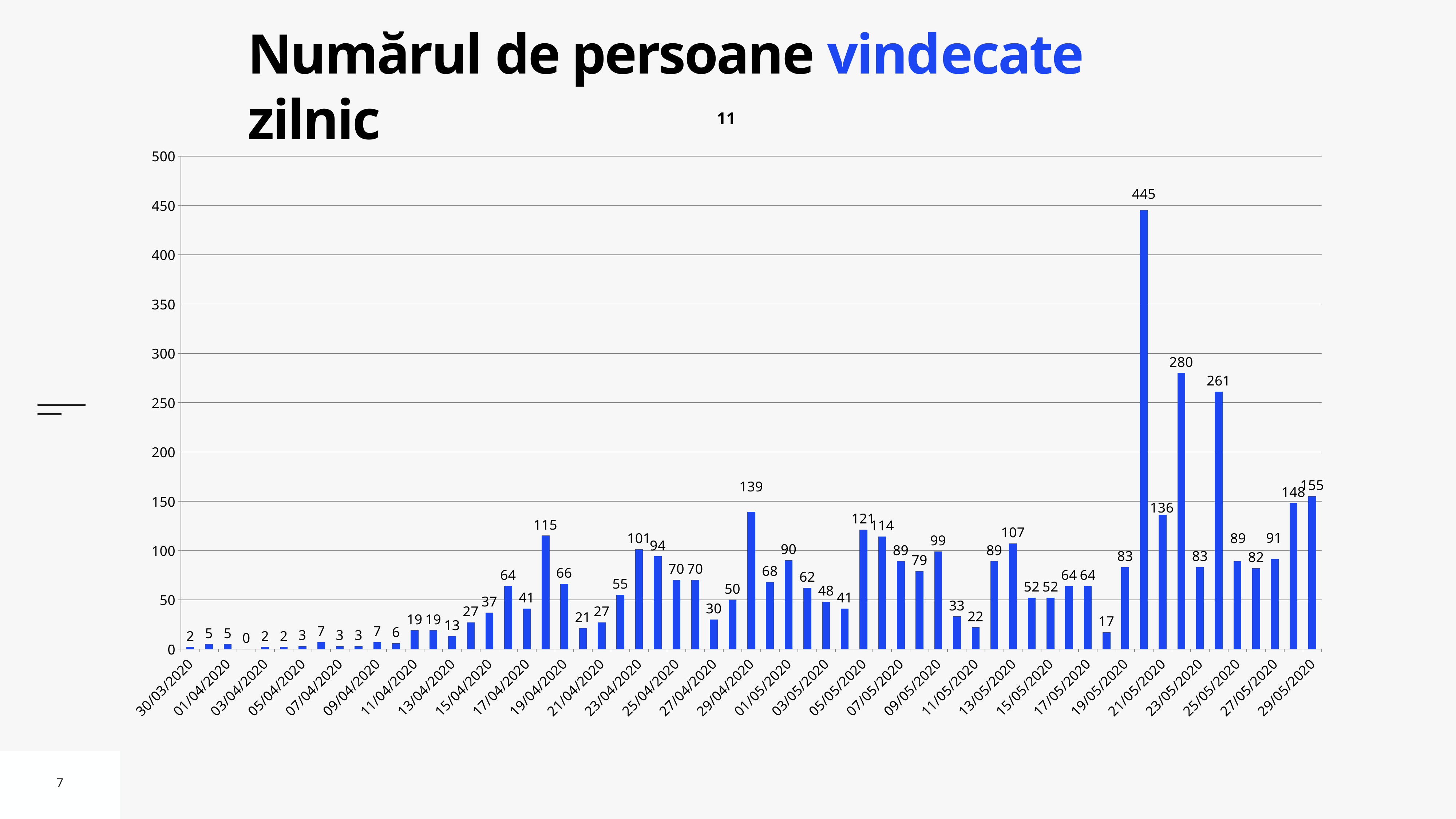
What kind of chart is shown on the slide? bar chart What is the value for 13/05/2020? 107 What is the value for 29/04/2020? 139 What is the value for 29/05/2020? 155 What is the highest daily value shown in the chart? 445 Which date has the larger value, 23/04/2020 or 01/05/2020? 23/04/2020 How many daily bars are plotted in the chart? 61 Is the value for 21/05/2020 greater or less than 100? greater What is the value for 23/05/2020? 83 What is the difference between the values for 29/05/2020 and 27/05/2020? 64 What is the lowest daily value shown in the chart? 0 What is the title of the slide? Numărul de persoane vindecate zilnic